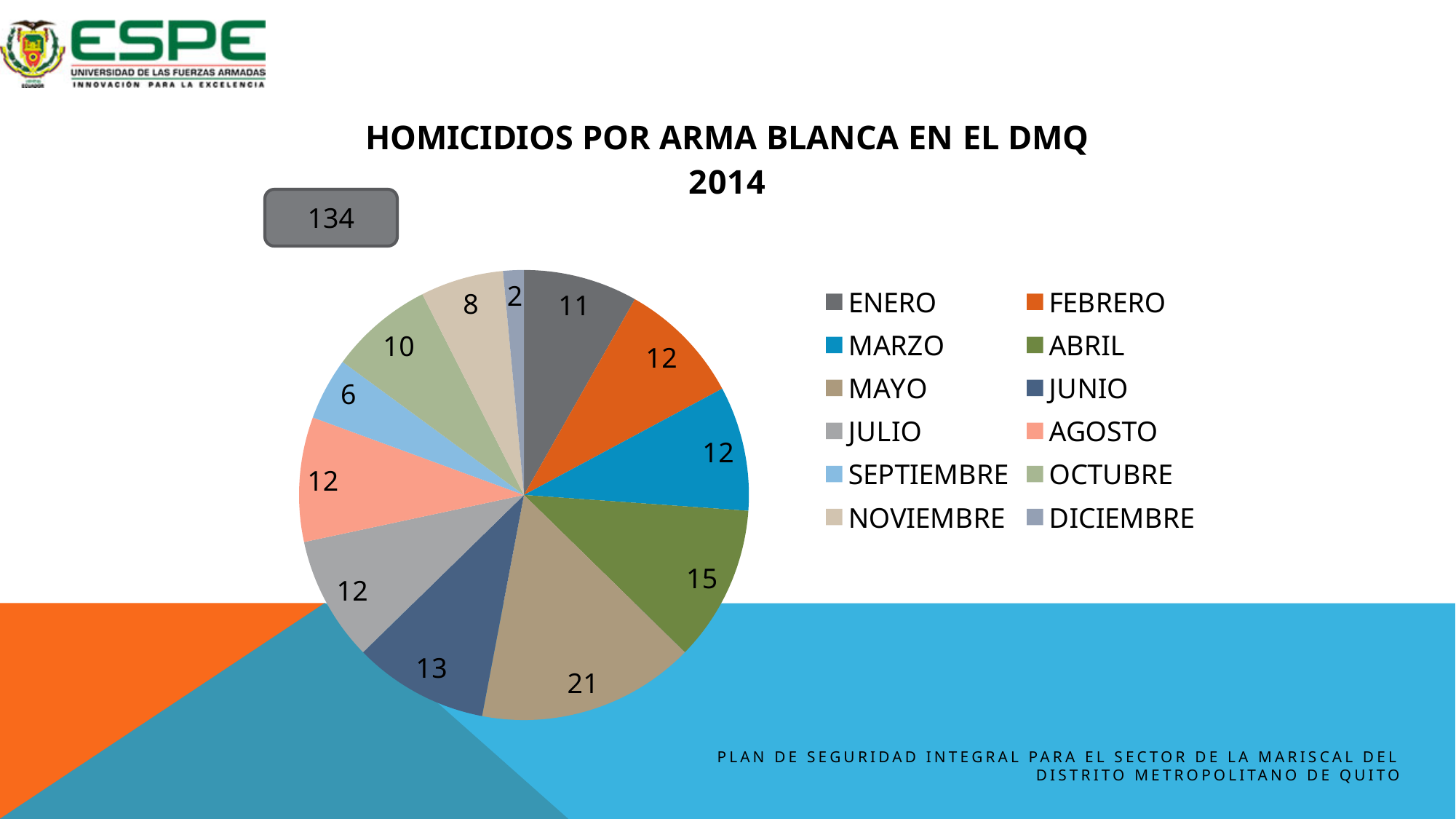
What is the value for MAYO in the pie chart? 21 What is the value for SEPTIEMBRE in the pie chart? 6 What type of chart is shown on the slide? pie chart Which month has the smallest slice in the pie chart? DICIEMBRE What is the value for DICIEMBRE in the pie chart? 2 What is the difference between the values for OCTUBRE and NOVIEMBRE? 2 Which is larger, the value for ABRIL or the value for ENERO? ABRIL Which month has the largest slice in the pie chart? MAYO What is the value for ABRIL in the pie chart? 15 What is the title of the chart? HOMICIDIOS POR ARMA BLANCA EN EL DMQ 2014 How many months (slices) does the pie chart show? 12 What is the difference between the values for MAYO and JUNIO? 8